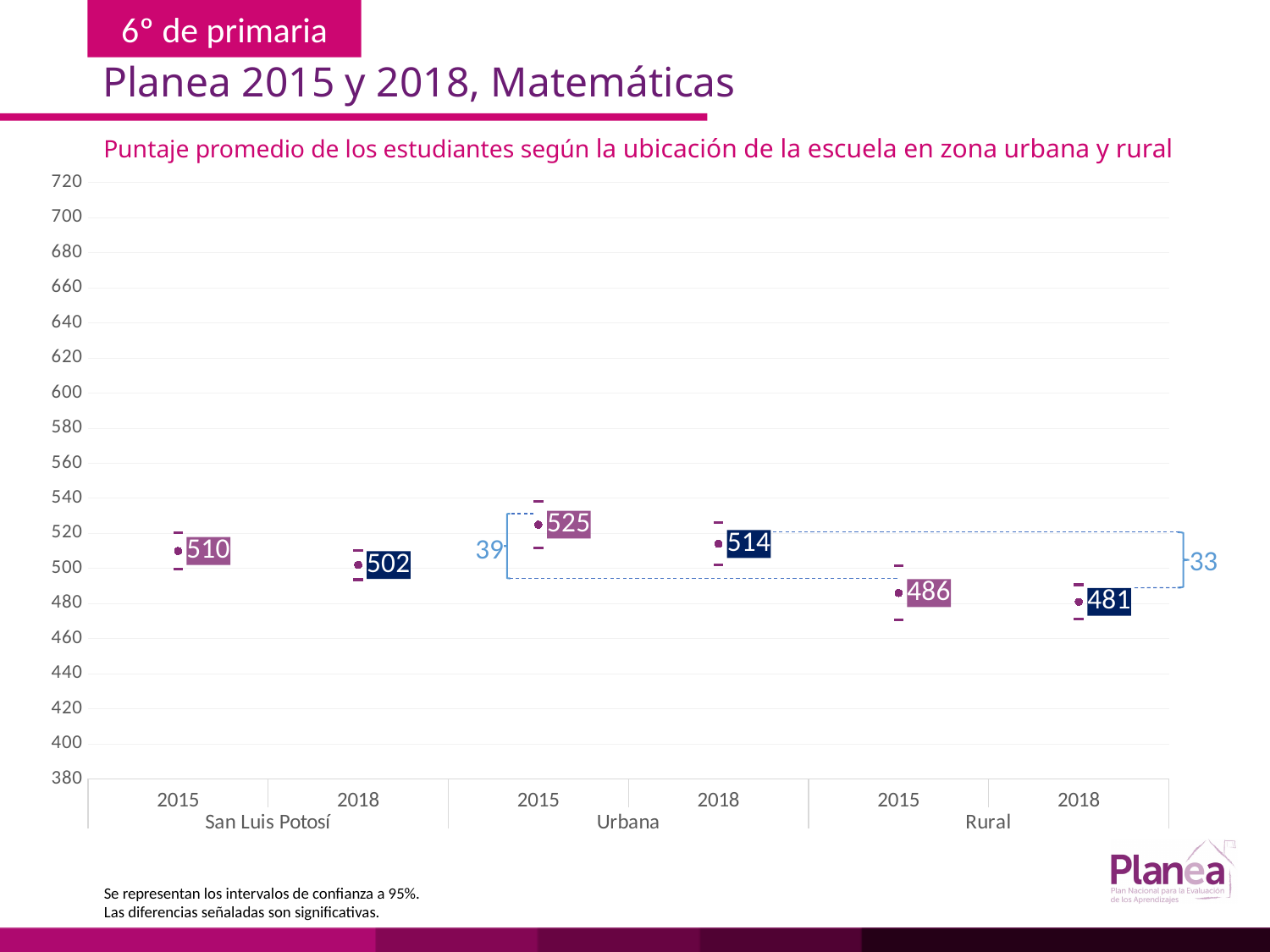
Which group and year has the lowest average score? Rural 2018 Which group and year has the highest average score? Urbana 2015 What is the difference between the Urbana and Rural scores in 2015? 39 What is the difference between the Urbana and Rural scores in 2018? 33 Which is larger, the Urbana score in 2018 or the San Luis Potosí score in 2015? Urbana 2018 What is the average score for Rural in 2018? 481 How many data points are plotted on the chart? 6 Did the Rural average score rise or fall from 2015 to 2018? fall What is the average score for Urbana in 2015? 525 What is the difference between the San Luis Potosí scores in 2015 and 2018? 8 What is the average score for San Luis Potosí in 2018? 502 What is the title of the chart? Puntaje promedio de los estudiantes según la ubicación de la escuela en zona urbana y rural